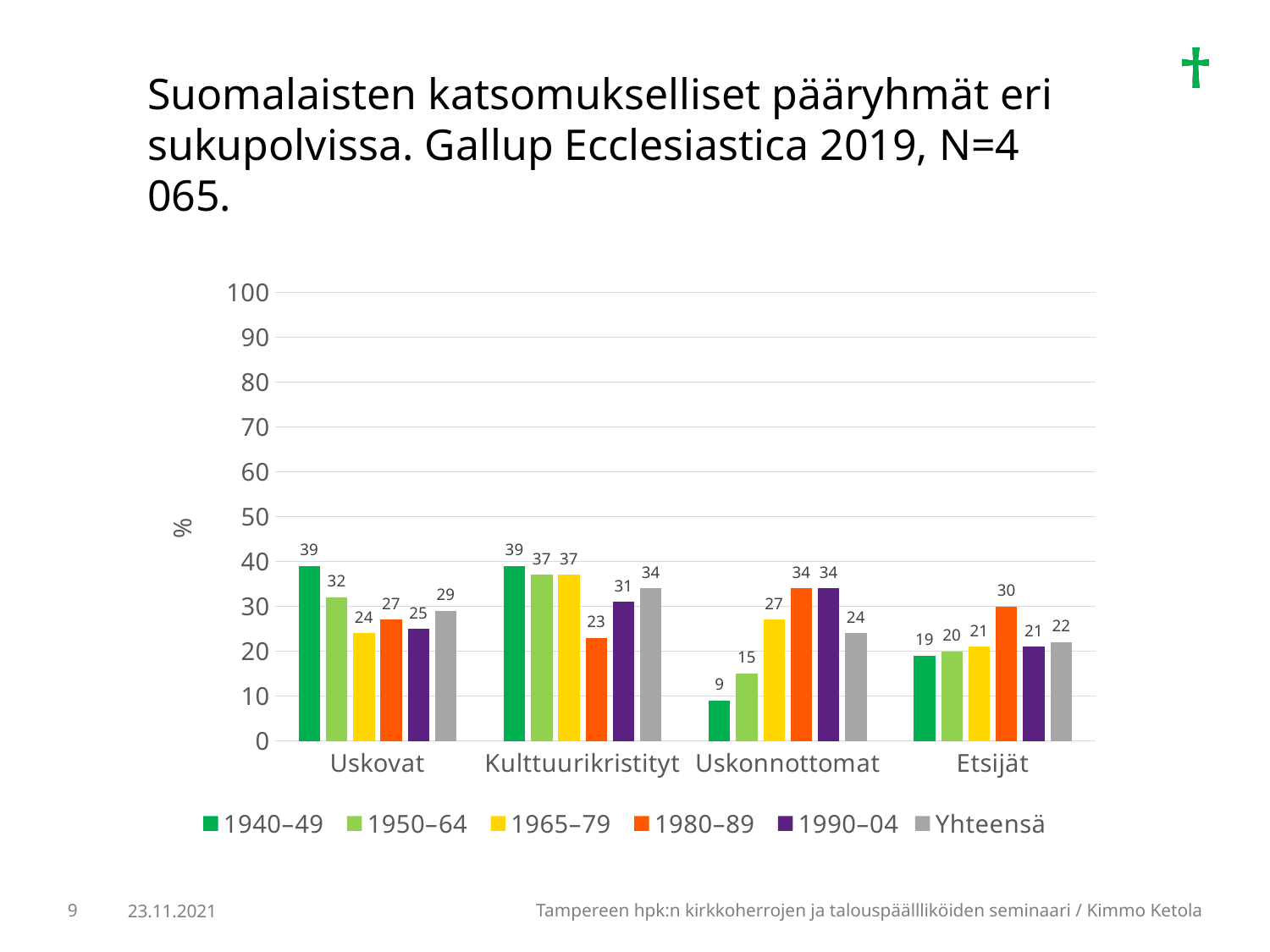
Which series has the highest value in the Etsijät category? 1980–89 What is the value for the 1940–49 series in the Uskovat category? 39 What is the value for the 1980–89 series in the Kulttuurikristityt category? 23 How many series does the legend list? 6 What is the label on the vertical axis? % Which series has the lowest value in the Uskonnottomat category? 1940–49 What is the difference between the 1940–49 and 1965–79 values in the Uskovat category? 15 What is the Yhteensä value for the Uskonnottomat category? 24 What kind of chart is shown on the slide? Bar chart Which is larger in the Uskonnottomat category: the 1950–64 value or the 1965–79 value? 1965–79 How many categories are shown on the x axis? 4 What is the value for the 1990–04 series in the Etsijät category? 21